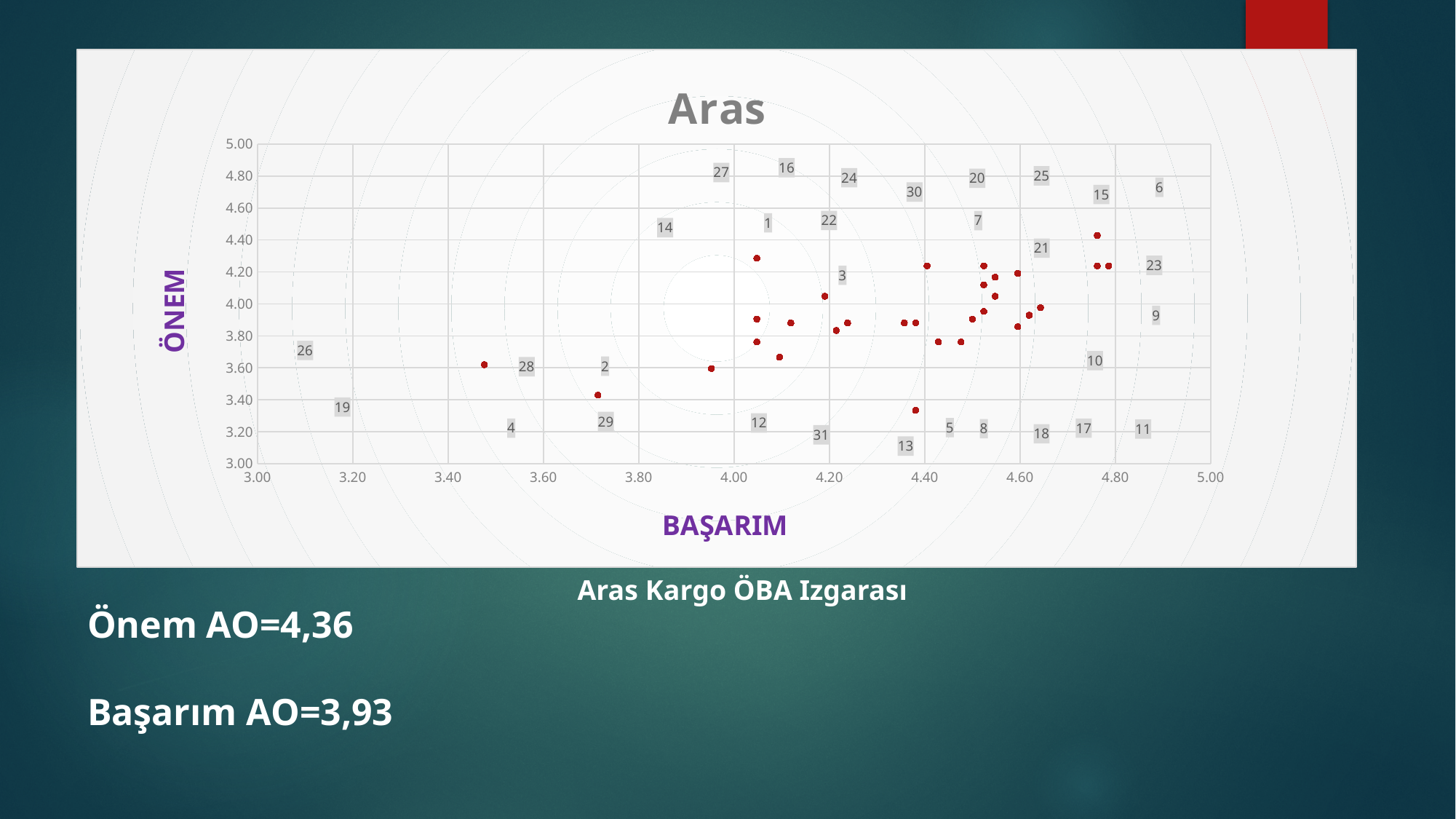
Is the ÖNEM value of the leftmost point in the chart greater or less than 4.00? less What kind of chart is shown on the slide? scatter chart Is the ÖNEM value of the highest point in the chart greater or less than 4.20? greater Is the ÖNEM value of the lowest point in the chart greater or less than 3.60? less Are more of the plotted points located to the right of BAŞARIM 4.00 or to the left of it? to the right What label is shown on the horizontal axis of the chart? BAŞARIM What is the title of the chart? Aras